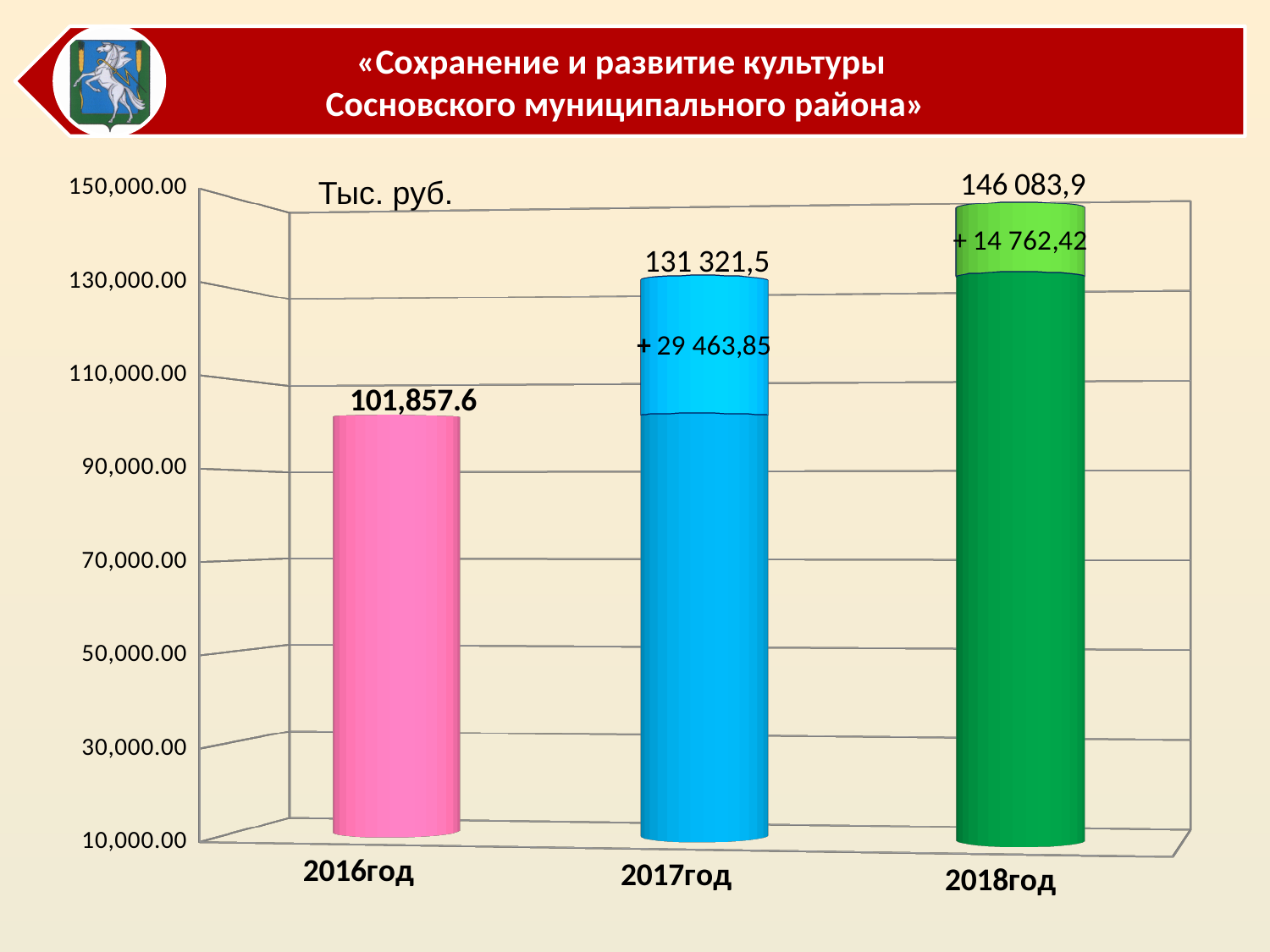
Which is larger, the value for 2017год or the value for 2016год? 2017год What increase is labelled on the 2017год bar? + 29 463,85 Which year has the lowest value? 2016год How many years are shown on the chart? 3 Do the values rise or fall from 2016год to 2018год? rise Which year has the highest value? 2018год What increase is labelled on the 2018год bar? + 14 762,42 Is the value for 2018год greater or less than 130,000.00? greater What kind of chart is shown on the slide? bar chart What is the value for 2018год? 146 083,9 What is the value for 2016год? 101,857.6 What is the value for 2017год? 131 321,5